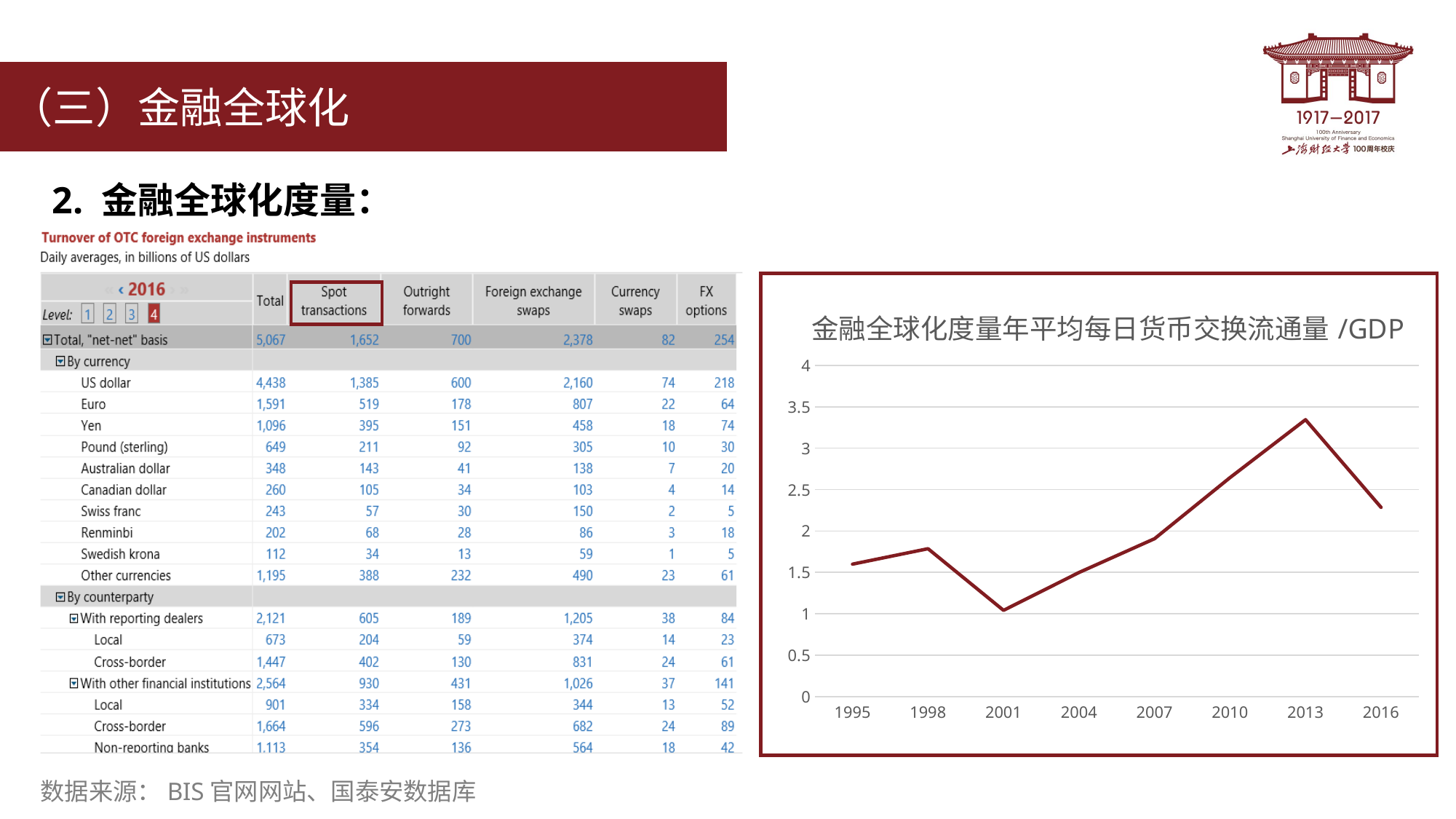
In the line chart on the right, which year has the larger value, 2013 or 2016? 2013 In the line chart on the right, which year has the highest value? 2013 In the line chart on the right, is the value for 2001 greater or less than 1.5? less In the line chart on the right, which year has the larger value, 1998 or 2001? 1998 What is the title of the line chart on the right? 金融全球化度量年平均每日货币交换流通量 /GDP In the line chart on the right, is the value for 2013 greater or less than 3? greater What kind of chart is shown on the right side of the slide? line chart In the line chart on the right, which year has the lowest value? 2001 In the line chart on the right, is the value for 1998 greater or less than 2? less In the line chart on the right, does the value rise or fall from 2001 to 2013? rise In the line chart on the right, how many years are shown on the x axis? 8